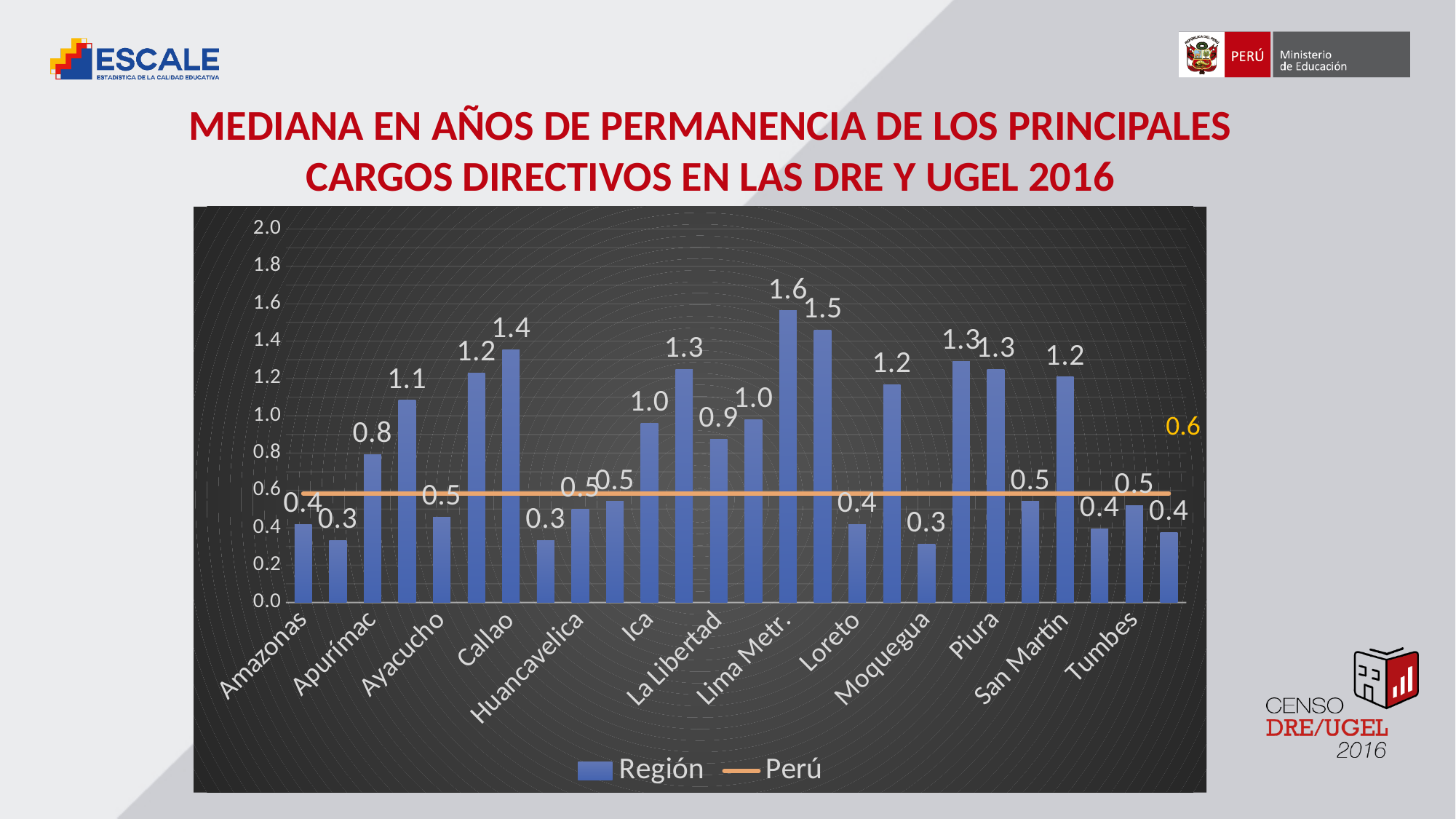
What is the value for Lima Metr.? 1.6 Is the value for San Martín greater or less than 1.0? greater What is the value of the Perú line? 0.6 What is the difference between the values for Callao and Amazonas? 1.0 What are the two entries in the legend? Región and Perú Which is larger, the value for Piura or the value for Ica? Piura What is the value for Callao? 1.4 What is the value for Moquegua? 0.3 What is the value for Apurímac? 0.8 How many series does the legend list? 2 What kind of chart is shown? bar and line chart Which labeled region has the highest value? Lima Metr.